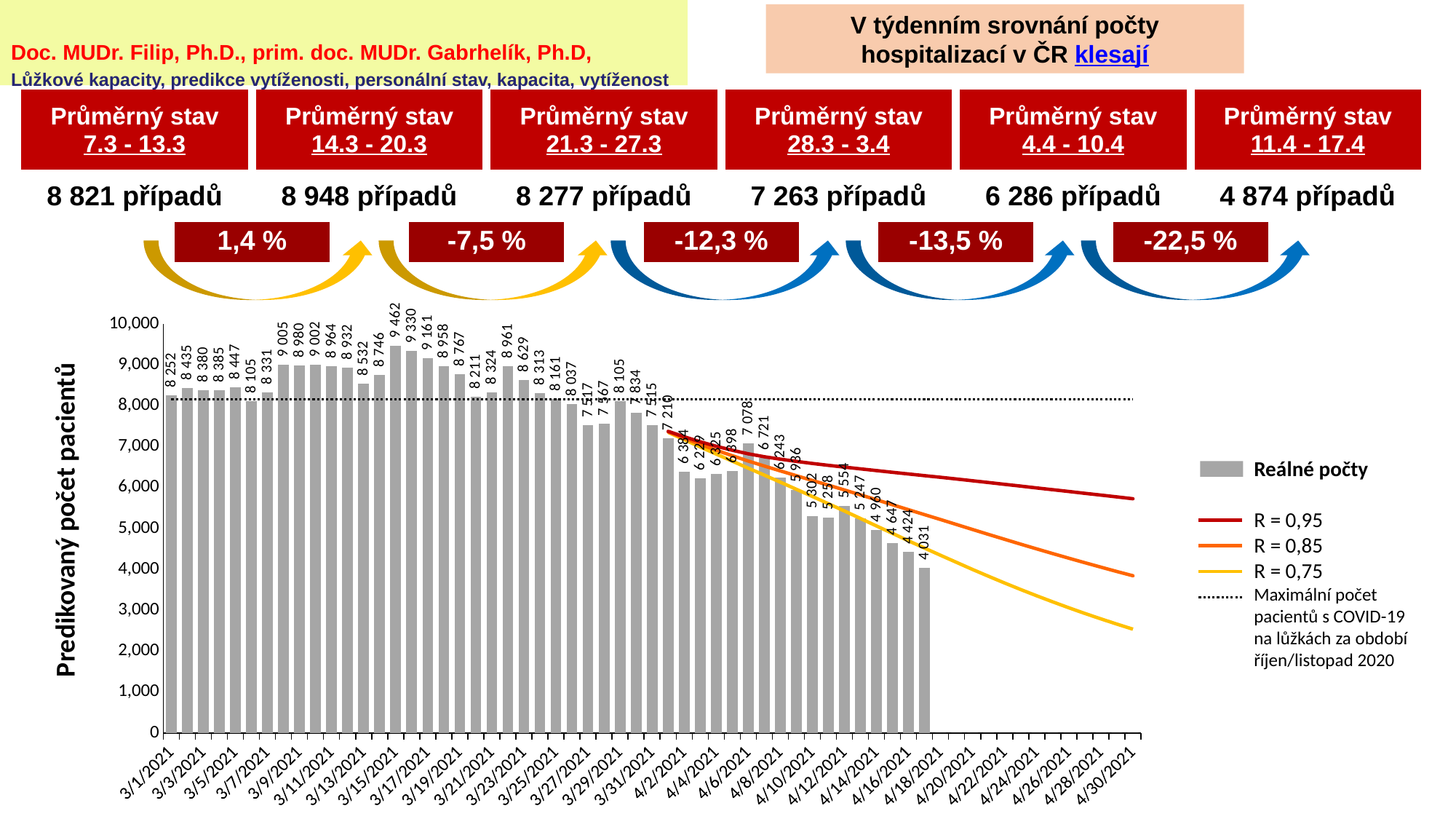
How many series does the chart legend list? 5 Do the gray bar values rise or fall from the end of March to mid-April 2021? fall What is the label of the vertical axis of the chart? Predikovaný počet pacientů What kind of chart is shown on the slide? combination bar and line chart What is the value of the last bar (the most recent real count) in the chart? 4 031 What is the highest value among the gray bars in the chart? 9 462 What is the lowest value among the gray bars in the chart? 4 031 Which is larger: the first bar (3/1/2021) or the last bar in the chart? the first bar (3/1/2021) Is the value of the R = 0,95 line at 4/30/2021 greater or less than 5,000? greater Is the value of the R = 0,75 line at 4/30/2021 greater or less than 3,000? less What is the difference between the highest bar value (9 462) and the lowest bar value (4 031)? 5 431 What is the value of the first bar (3/1/2021) in the chart? 8 252